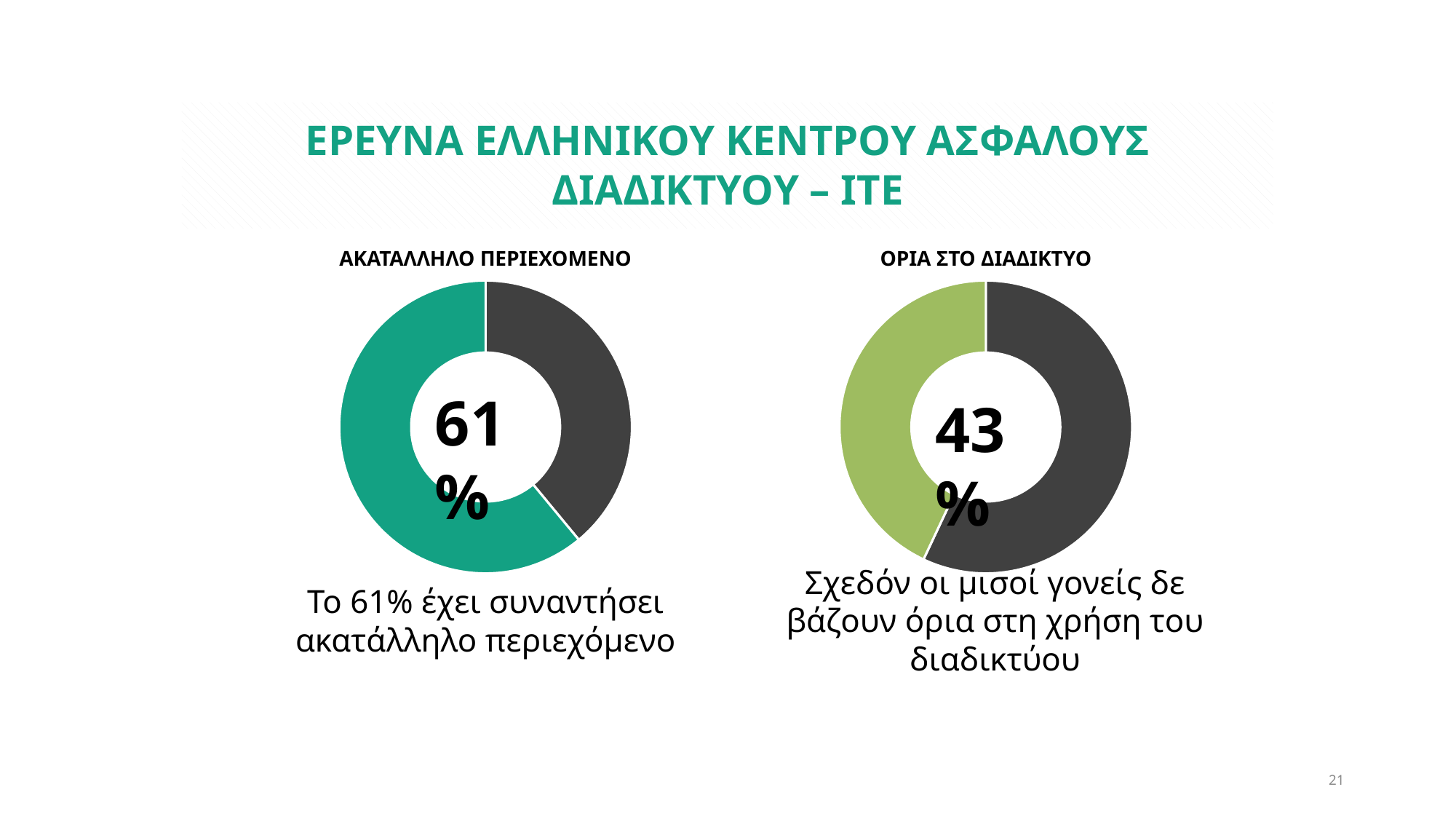
How many slices does the ΟΡΙΑ ΣΤΟ ΔΙΑΔΙΚΤΥΟ chart have? 2 Which of the two charts shows the higher highlighted percentage? ΑΚΑΤΑΛΛΗΛΟ ΠΕΡΙΕΧΟΜΕΝΟ In the ΑΚΑΤΑΛΛΗΛΟ ΠΕΡΙΕΧΟΜΕΝΟ chart, which slice is larger, the teal one or the dark grey one? The teal one What kind of chart is used for ΑΚΑΤΑΛΛΗΛΟ ΠΕΡΙΕΧΟΜΕΝΟ? Doughnut (pie) chart How many slices does the ΑΚΑΤΑΛΛΗΛΟ ΠΕΡΙΕΧΟΜΕΝΟ chart have? 2 What colour is the highlighted slice in the ΟΡΙΑ ΣΤΟ ΔΙΑΔΙΚΤΥΟ chart? Green In the ΑΚΑΤΑΛΛΗΛΟ ΠΕΡΙΕΧΟΜΕΝΟ chart, what percentage is printed in the centre? 61% In the ΟΡΙΑ ΣΤΟ ΔΙΑΔΙΚΤΥΟ chart, what percentage is printed in the centre? 43% What is the difference between the percentage shown in the ΑΚΑΤΑΛΛΗΛΟ ΠΕΡΙΕΧΟΜΕΝΟ chart and the percentage shown in the ΟΡΙΑ ΣΤΟ ΔΙΑΔΙΚΤΥΟ chart? 18 percentage points In the ΟΡΙΑ ΣΤΟ ΔΙΑΔΙΚΤΥΟ chart, which slice is larger, the green one or the dark grey one? The dark grey one What is the title of the chart on the right side of the slide? ΟΡΙΑ ΣΤΟ ΔΙΑΔΙΚΤΥΟ